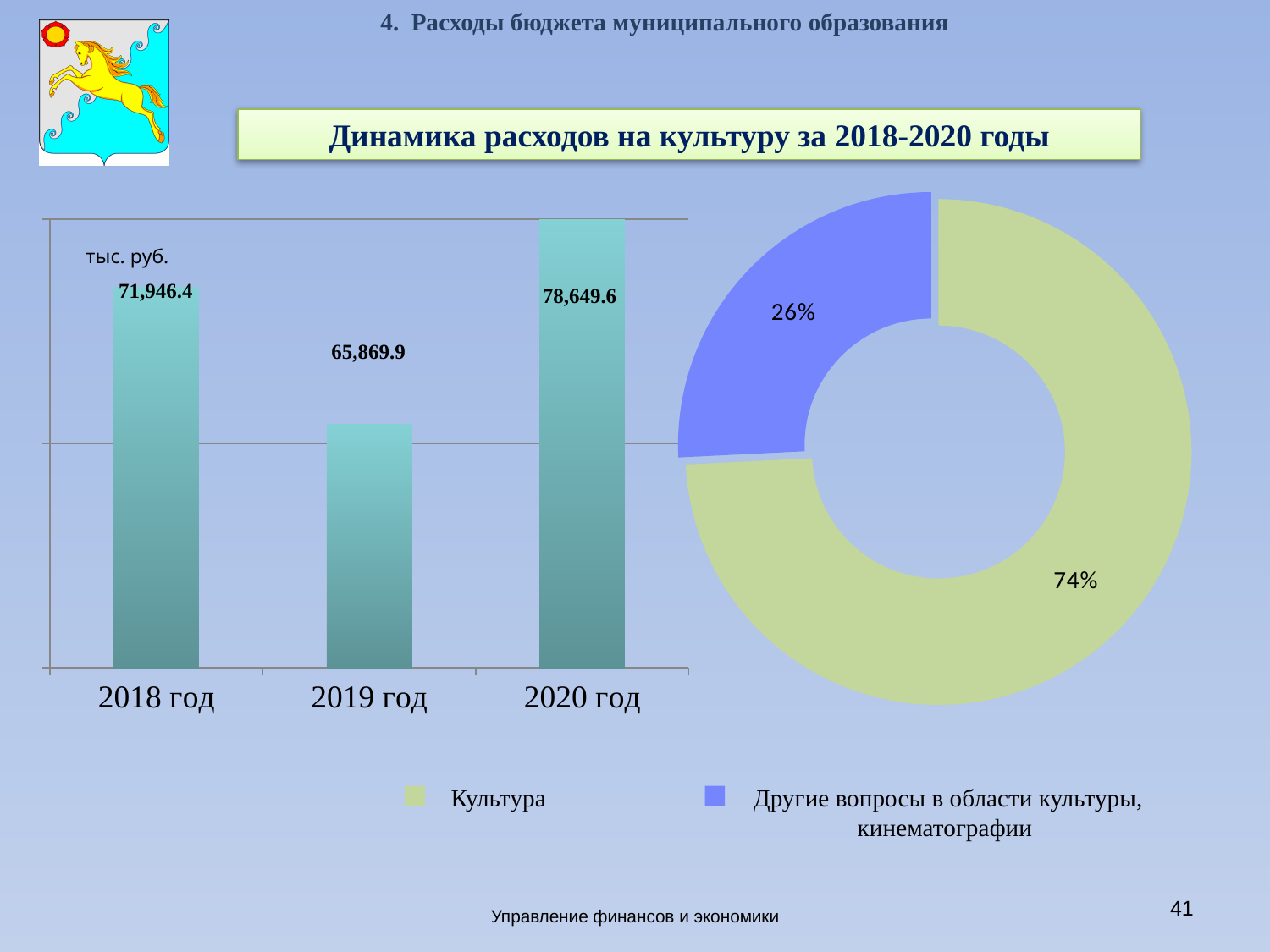
In the bar chart on the left, what is the value for 2019 год? 65,869.9 In the bar chart on the left, what is the value for 2018 год? 71,946.4 In the bar chart on the left, which is larger: the value for 2018 год or 2019 год? 2018 год In the bar chart on the left, what is the value for 2020 год? 78,649.6 What kind of chart is shown on the left of the slide? bar chart In the bar chart on the left, which year has the highest value? 2020 год In the doughnut chart on the right, which colour represents Культура? light green In the bar chart on the left, what is the difference between the values for 2020 год and 2019 год? 12,779.7 In the doughnut chart on the right, what share does Другие вопросы в области культуры, кинематографии have? 26% How many bars are in the bar chart on the left? 3 In the doughnut chart on the right, what share does Культура have? 74% In the bar chart on the left, which year has the lowest value? 2019 год